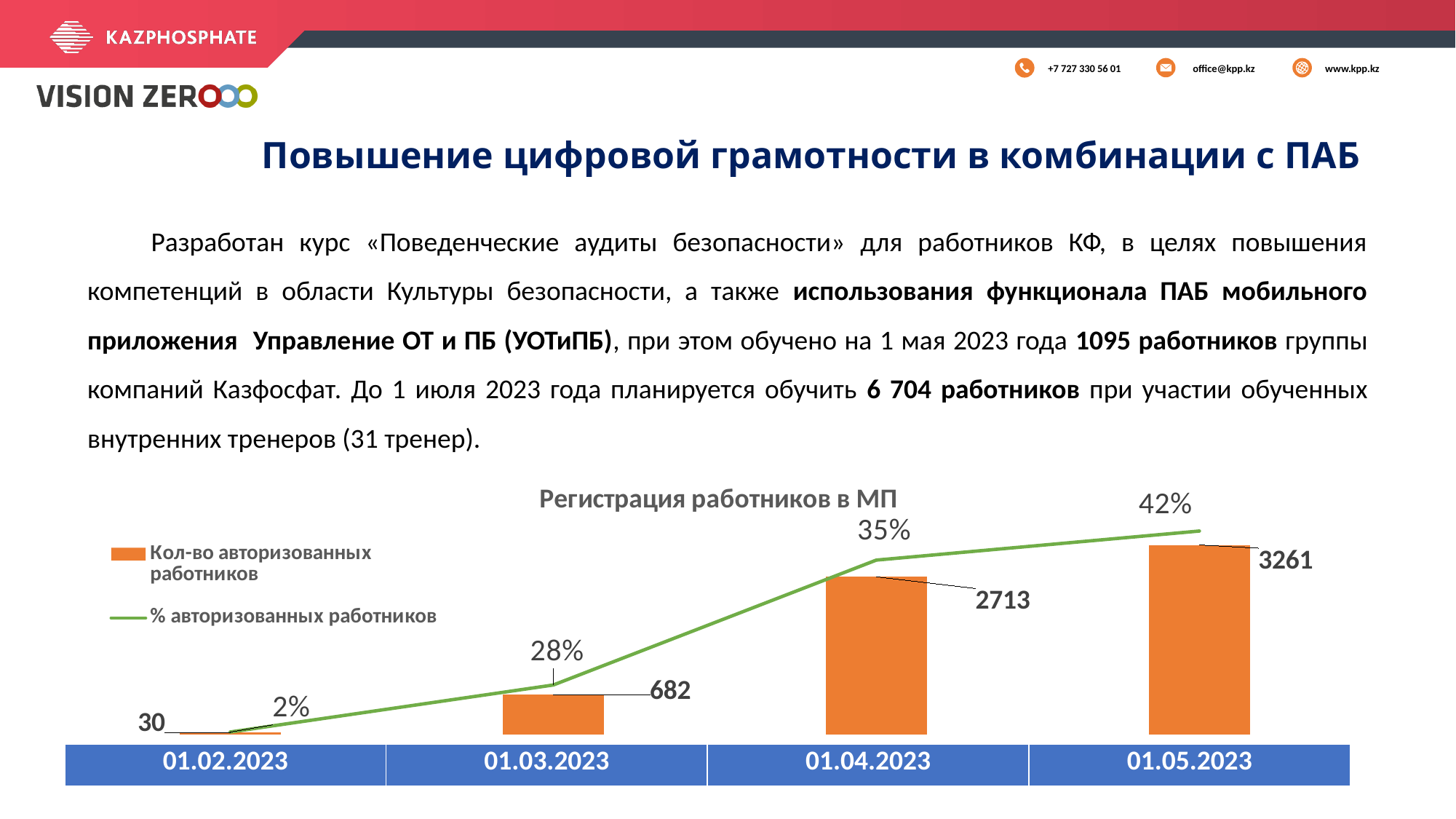
Which date has the highest number of authorized employees? 01.05.2023 How many dates are shown on the x axis of the chart? 4 What is the percentage of authorized employees (% авторизованных работников) on 01.03.2023? 28% What is the percentage of authorized employees on 01.04.2023? 35% What is the number of authorized employees (Кол-во авторизованных работников) on 01.05.2023? 3261 What is the difference in the number of authorized employees between 01.04.2023 and 01.03.2023? 2031 What is the number of authorized employees on 01.02.2023? 30 What is the title of the chart? Регистрация работников в МП Which date has the lowest percentage of authorized employees? 01.02.2023 Does the percentage of authorized employees rise or fall from 01.02.2023 to 01.05.2023? rise How many series does the chart legend list? 2 Which is larger: the number of authorized employees on 01.03.2023 or on 01.04.2023? 01.04.2023